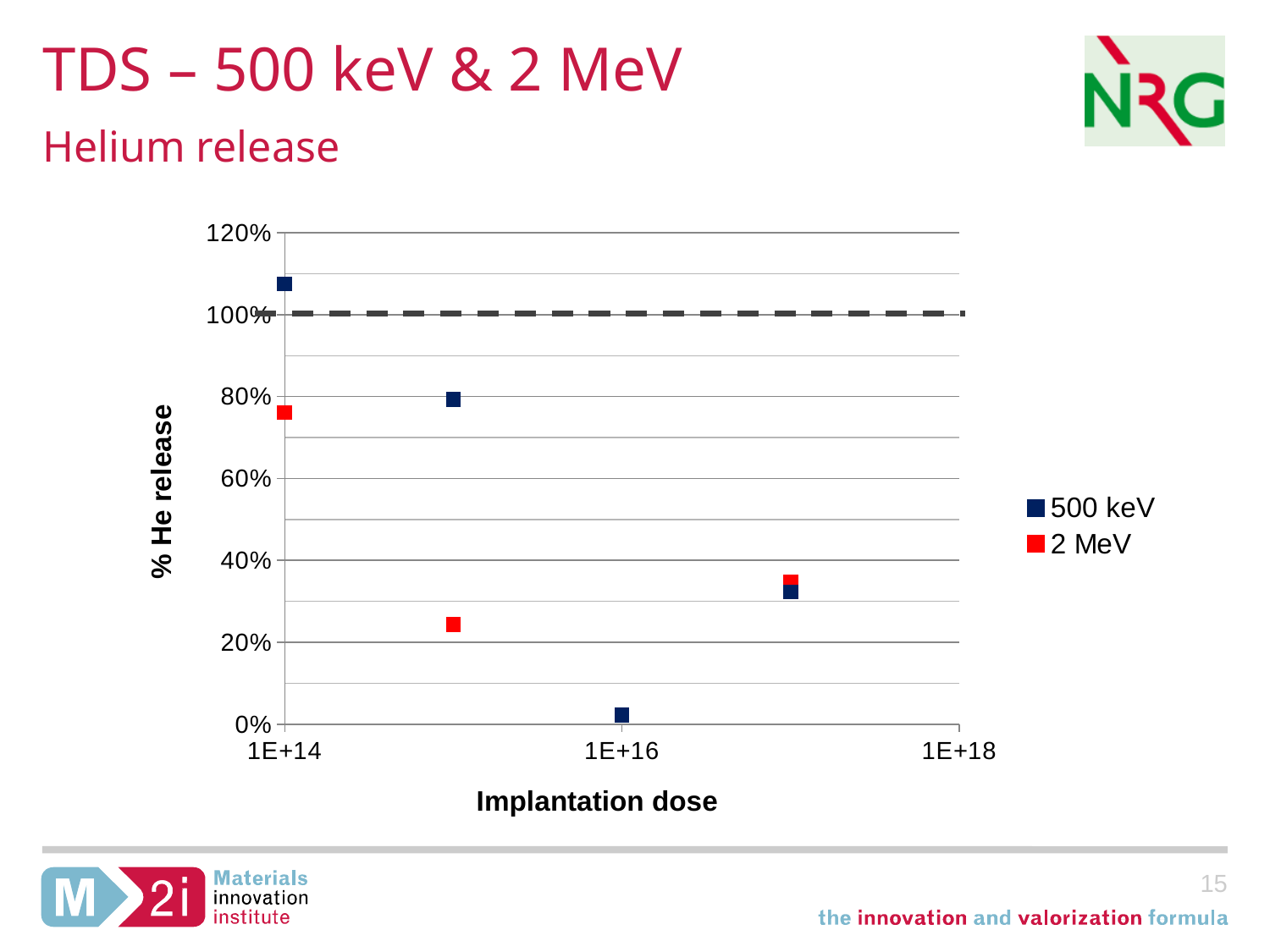
What is the title of the y axis? % He release Is the 2 MeV value at an implantation dose of 1E+14 greater or less than 60%? greater Which series contains the highest plotted % He release value? 500 keV Is the 500 keV value at an implantation dose of 1E+16 greater or less than 20%? less Is the 500 keV value at an implantation dose of 1E+14 greater or less than 100%? greater How many series does the legend list? 2 How many data points are plotted for the 500 keV series? 4 What kind of chart is shown on the slide? scatter chart At an implantation dose of 1E+14, which series has the higher % He release, 500 keV or 2 MeV? 500 keV At which implantation dose does the 500 keV series reach its lowest % He release? 1E+16 What are the two series named in the legend? 500 keV and 2 MeV